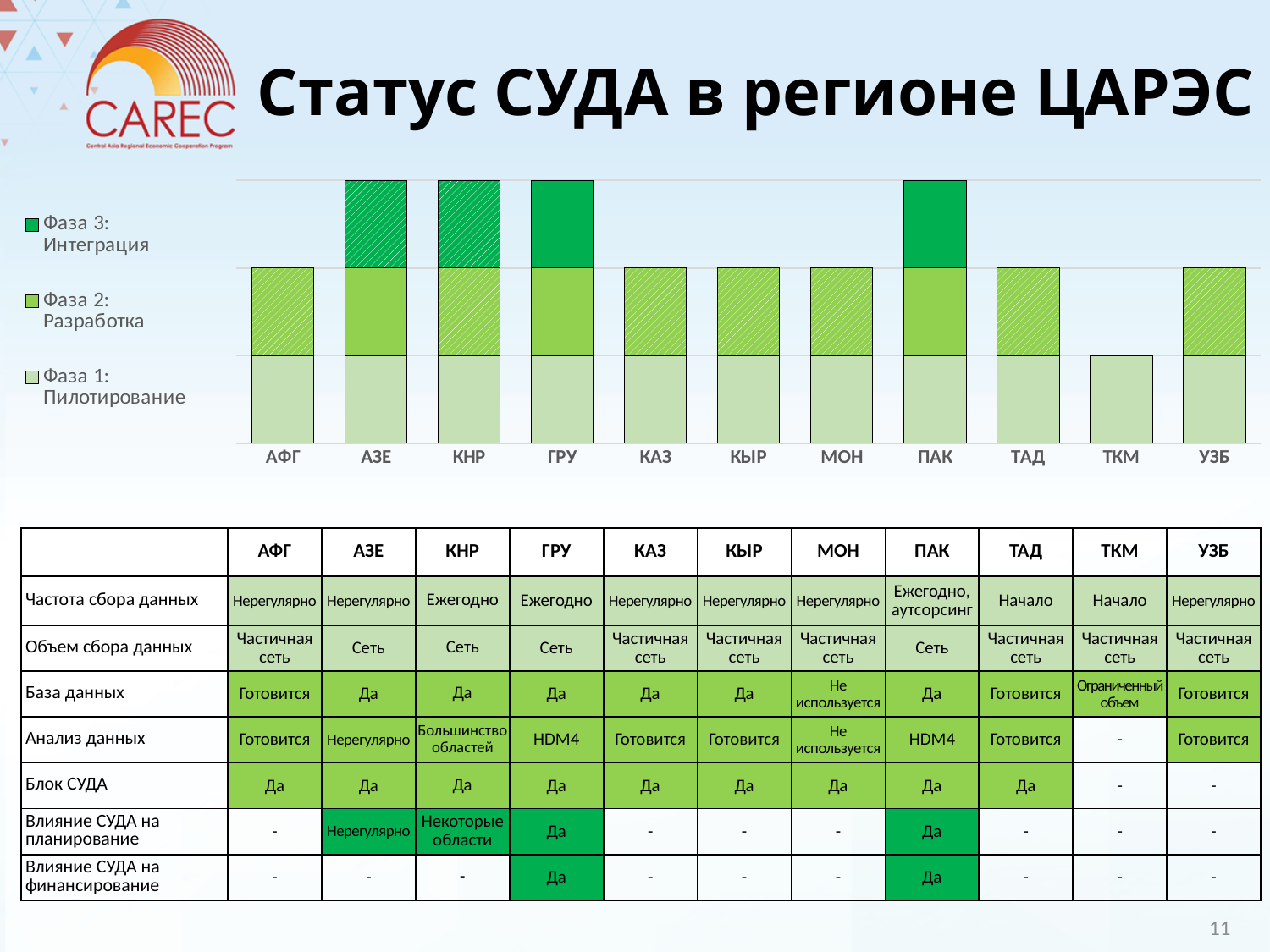
Is the bar for ПАК taller or shorter than the bar for ТАД? Taller Which countries have bars that include the Фаза 3: Интеграция segment? АЗЕ, КНР, ГРУ, ПАК How many countries (categories) are shown on the x axis of the chart? 11 How many series does the chart legend list? 3 Which is the topmost phase segment in the bar for ТКМ? Фаза 1: Пилотирование Is the bar for ГРУ taller or shorter than the bar for ТКМ? Taller What is the label of the last category on the x axis? УЗБ What is the first entry in the chart legend? Фаза 3: Интеграция Which legend entry corresponds to the lightest green colour in the chart? Фаза 1: Пилотирование What kind of chart is shown on the slide? Stacked bar chart Which is the topmost phase segment in the bar for КАЗ? Фаза 2: Разработка Which country has the shortest bar in the chart? ТКМ